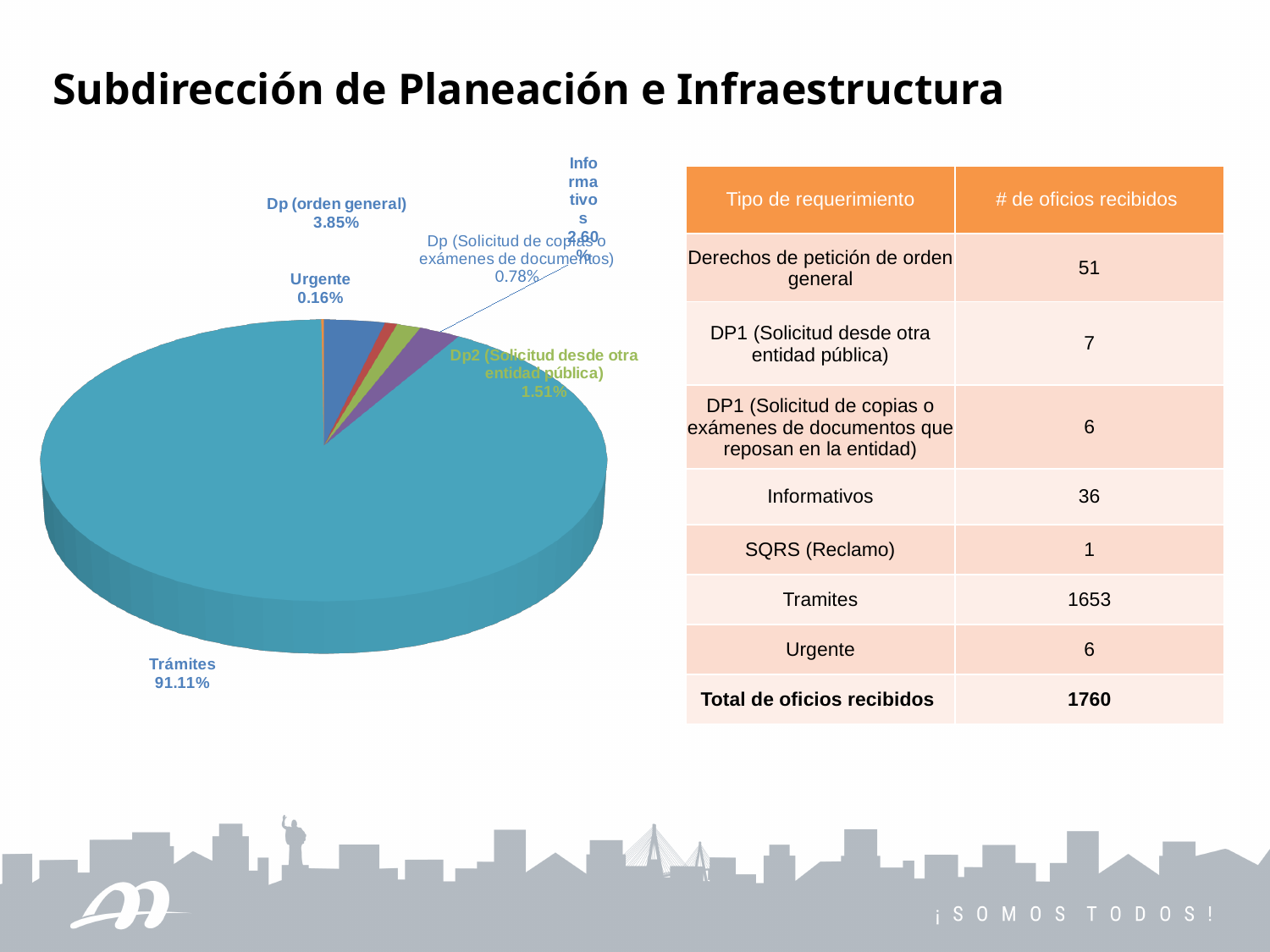
What percentage is shown for Urgente in the pie chart? 0.16% What is the difference between the Dp2 (Solicitud desde otra entidad pública) share and the Dp (Solicitud de copias o exámenes de documentos) share in the pie chart? 0.73% Which has a larger share in the pie chart, Dp (orden general) or Dp2 (Solicitud desde otra entidad pública)? Dp (orden general) What kind of chart is shown on the slide? Pie chart What percentage share does the Trámites slice have in the pie chart? 91.11% What percentage is shown for Dp (orden general) in the pie chart? 3.85% What percentage is shown for Dp (Solicitud de copias o exámenes de documentos) in the pie chart? 0.78% By how many percentage points does the Trámites share exceed the Dp (orden general) share in the pie chart? 87.26% Which category has the largest slice in the pie chart? Trámites What percentage is shown for Dp2 (Solicitud desde otra entidad pública) in the pie chart? 1.51% What colour is the Trámites slice in the pie chart? Teal Which labeled category has the smallest share in the pie chart? Urgente